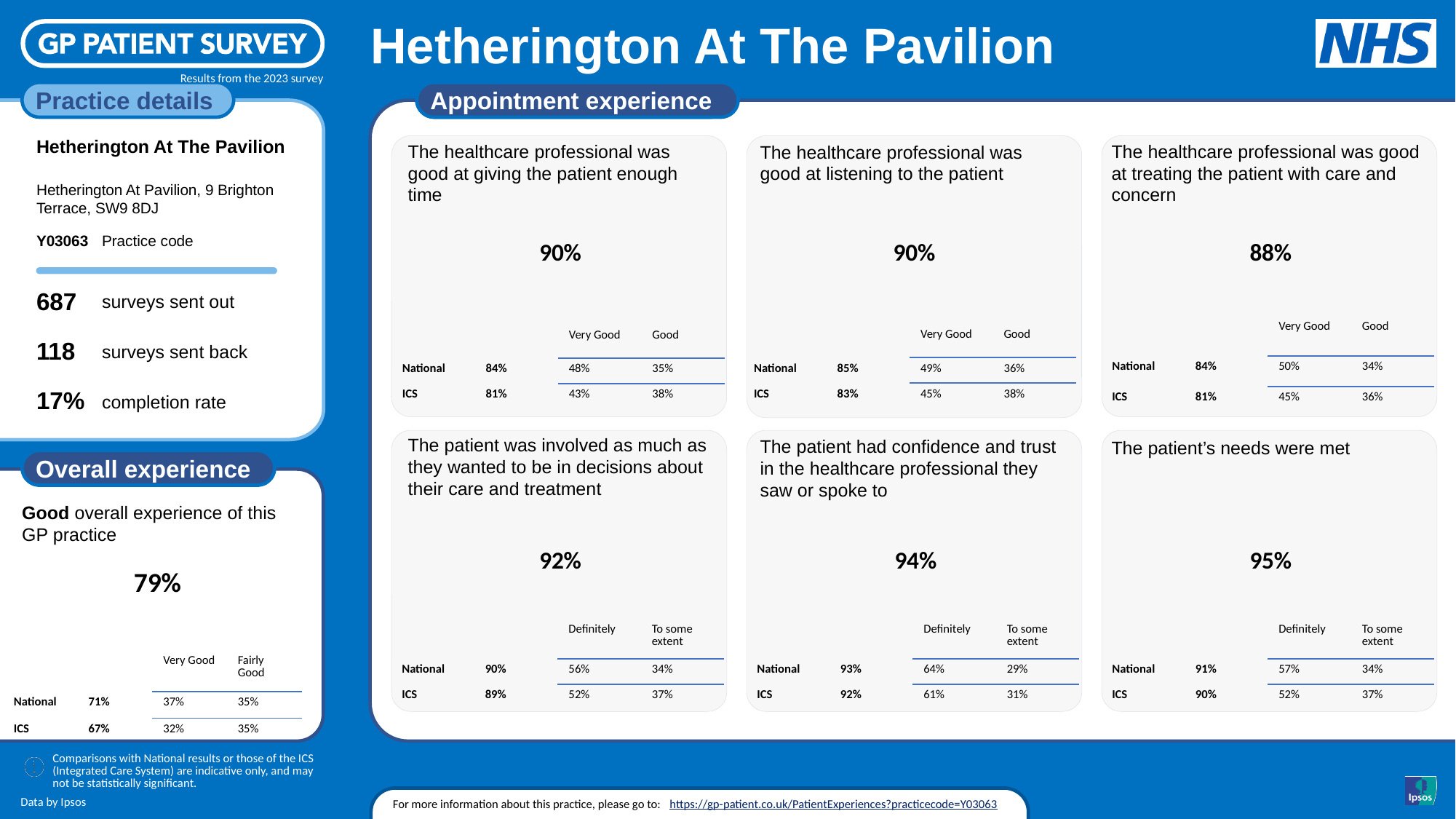
In the 'Overall experience' panel, what is the National value for good overall experience? 71% In the panel 'The healthcare professional was good at treating the patient with care and concern', what is the National value? 84% In the panel 'The patient's needs were met', which is larger: the National value or the ICS value? National Which of the six 'Appointment experience' panels has the highest practice headline percentage? The patient's needs were met Which of the six 'Appointment experience' panels has the lowest practice headline percentage? The healthcare professional was good at treating the patient with care and concern In the panel 'The healthcare professional was good at listening to the patient', what is the ICS 'Very Good' value? 45% In the panel 'The patient had confidence and trust in the healthcare professional they saw or spoke to', what is the National 'Definitely' value? 64% In the 'Overall experience' panel, what is the difference between the practice's 79% and the National 71%? 8 percentage points In the 'Overall experience' panel, what percentage of patients reported a good overall experience of this GP practice? 79% In the panel 'The patient was involved as much as they wanted to be in decisions about their care and treatment', what is the difference between the National 'Definitely' value and the ICS 'Definitely' value? 4 percentage points In the panel 'The healthcare professional was good at giving the patient enough time', what is the practice's headline percentage? 90% In the 'Overall experience' panel, what is the ICS 'Very Good' value? 32%